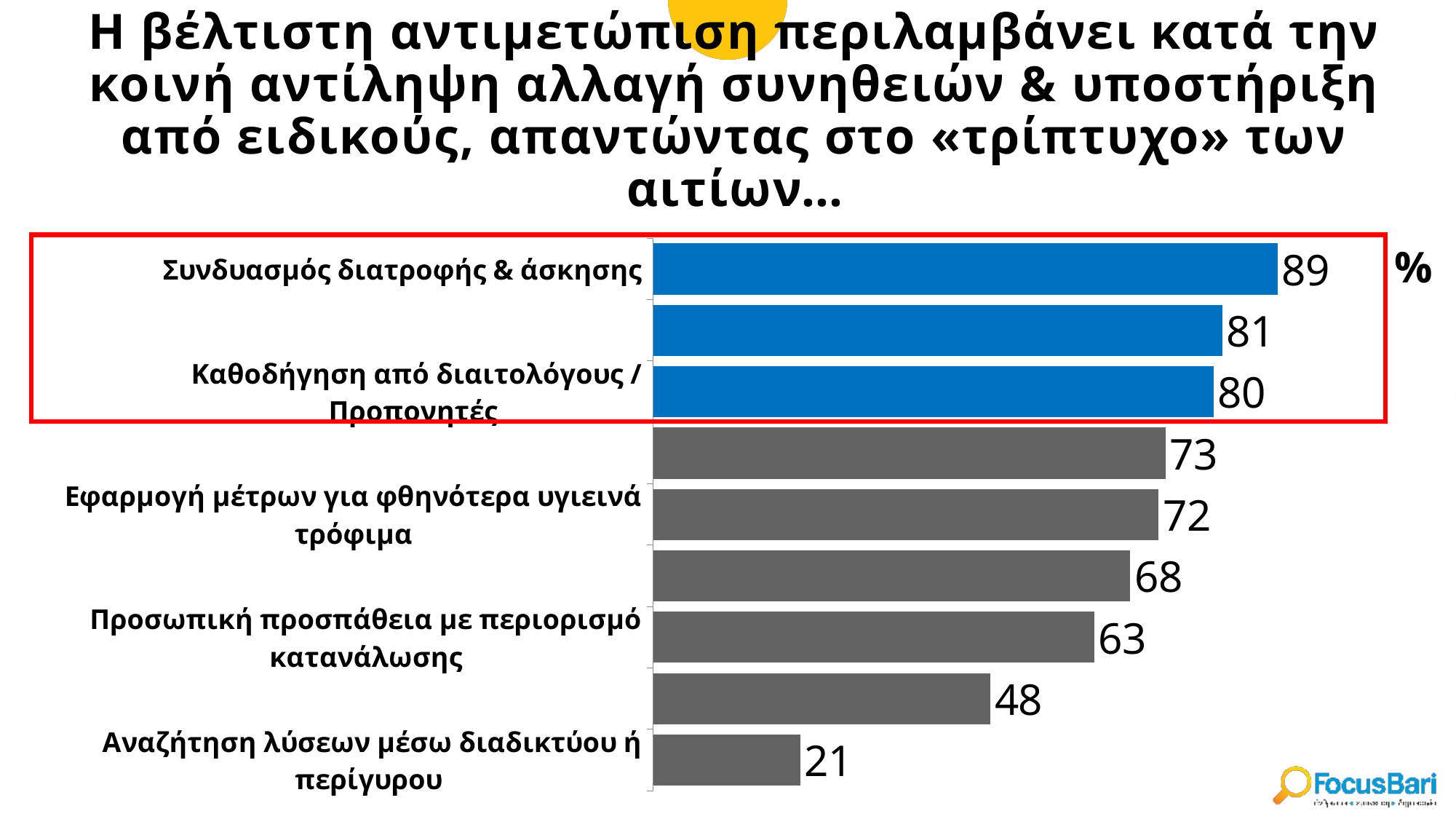
Which category has the lowest value? Αναζήτηση λύσεων μέσω διαδικτύου ή περίγυρου What is the value for "Εφαρμογή μέτρων για φθηνότερα υγιεινά τρόφιμα"? 72 What is the value for "Προσωπική προσπάθεια με περιορισμό κατανάλωσης"? 63 What is the difference between the values for "Συνδυασμός διατροφής & άσκησης" and "Αναζήτηση λύσεων μέσω διαδικτύου ή περίγυρου"? 68 What is the value for "Αναζήτηση λύσεων μέσω διαδικτύου ή περίγυρου"? 21 What is the value for "Συνδυασμός διατροφής & άσκησης"? 89 What type of chart is shown on the slide? bar chart What is the value for "Καθοδήγηση από διαιτολόγους / Προπονητές"? 80 Which category has the highest value? Συνδυασμός διατροφής & άσκησης What colour are the bars inside the red box? blue Which is larger, the value for "Καθοδήγηση από διαιτολόγους / Προπονητές" or for "Προσωπική προσπάθεια με περιορισμό κατανάλωσης"? Καθοδήγηση από διαιτολόγους / Προπονητές How many bars are plotted in the chart? 9